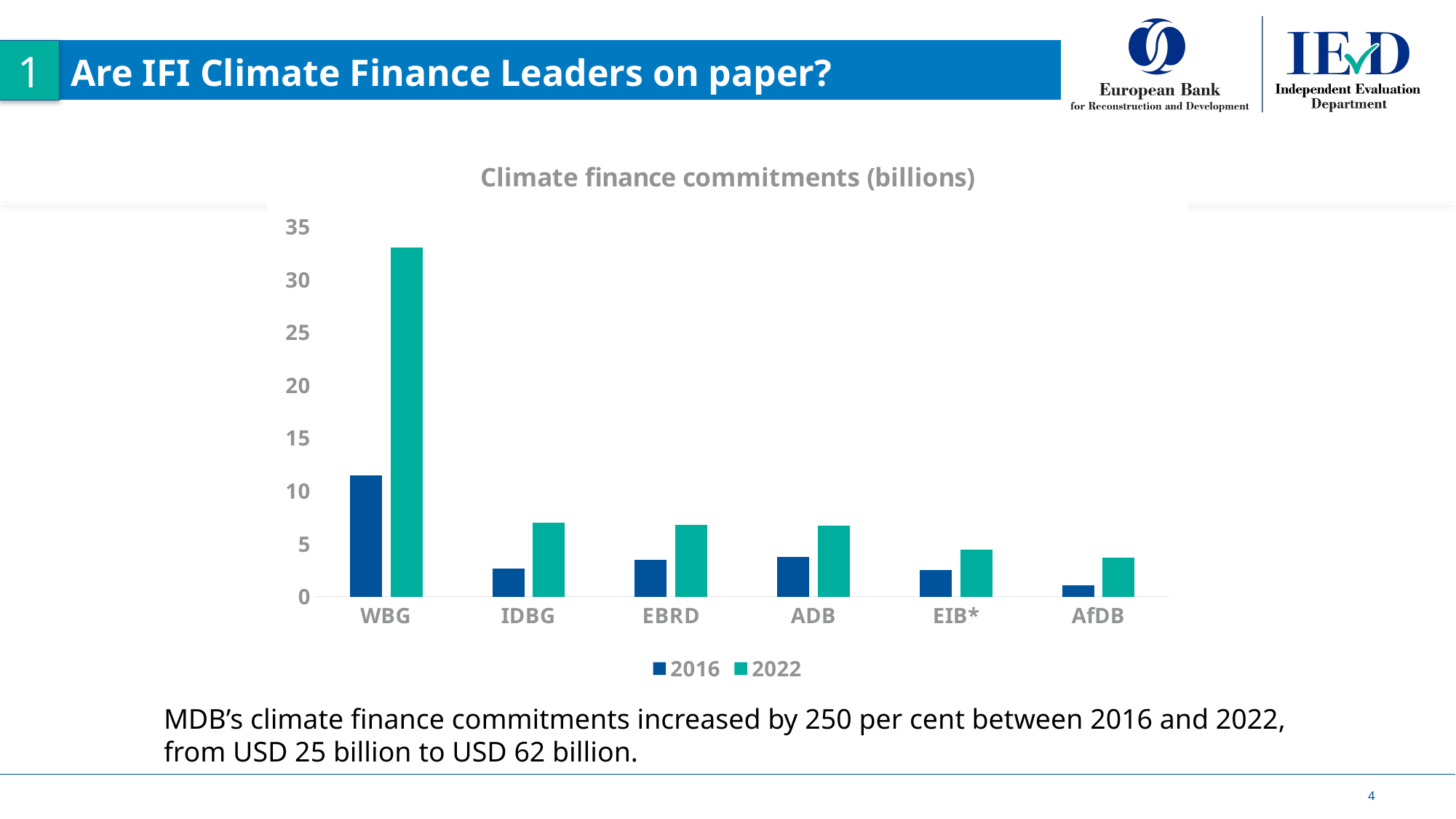
Is the 2016 value for WBG greater or less than 10? greater How many series does the legend list in the chart? 2 Which institution has the highest 2022 climate finance commitment? WBG What is the title of the chart? Climate finance commitments (billions) Which is larger: the 2022 value for ADB or the 2022 value for EIB*? 2022 value for ADB Is the 2022 value for WBG greater or less than 30? greater Is the 2016 value for AfDB greater or less than 5? less What kind of chart is shown on the slide? bar chart How many institutions are shown on the x axis of the chart? 6 Which is larger: the 2016 value for WBG or the 2022 value for IDBG? 2016 value for WBG Which years are listed in the chart legend? 2016 and 2022 Which institution has the lowest 2016 climate finance commitment? AfDB